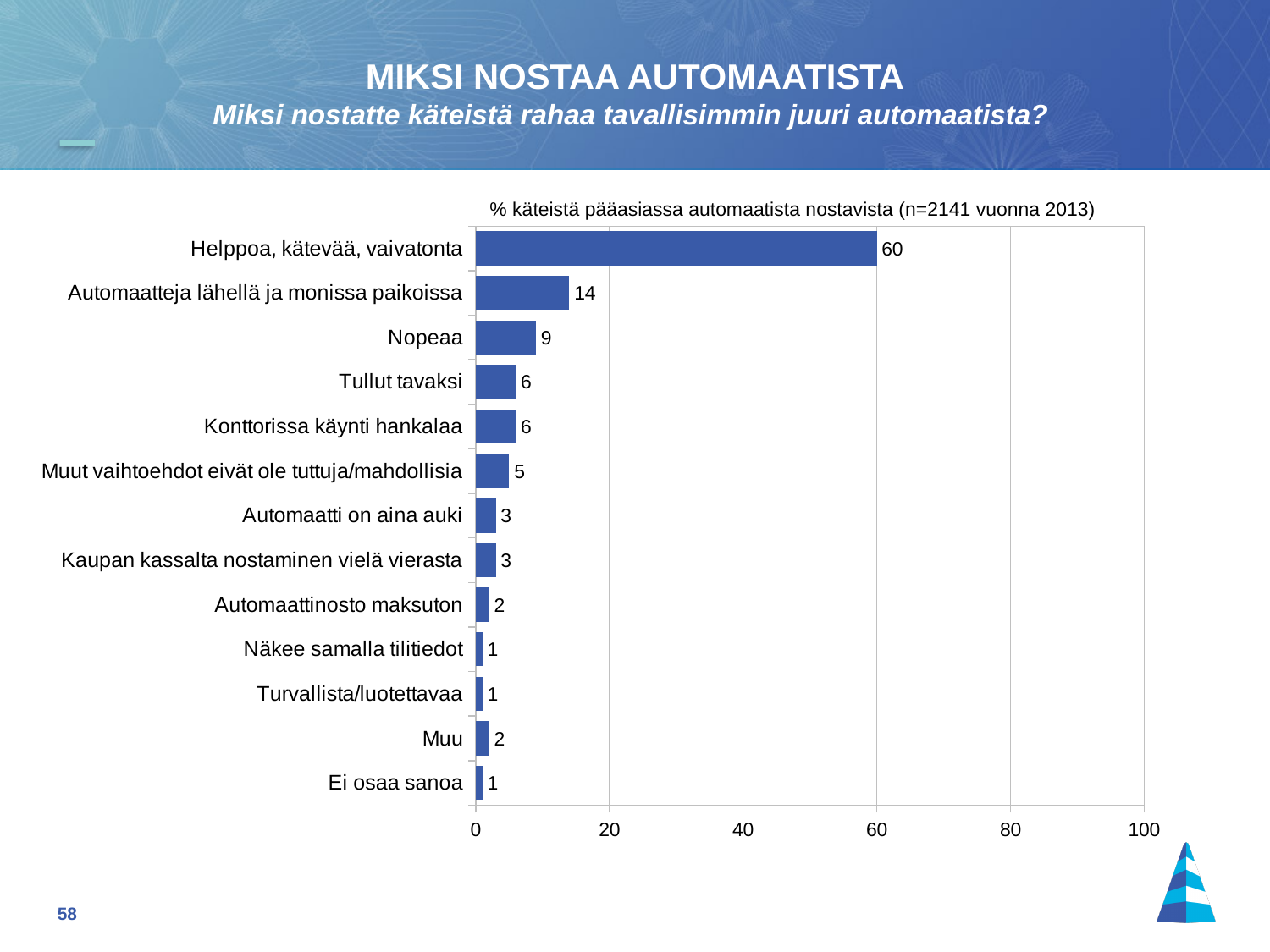
What is the value for "Automaatteja lähellä ja monissa paikoissa"? 14 What is the chart's title? % käteistä pääasiassa automaatista nostavista (n=2141 vuonna 2013) Which category has the highest value? Helppoa, kätevää, vaivatonta What is the value for "Nopeaa"? 9 What is the difference between the values for "Helppoa, kätevää, vaivatonta" and "Automaatteja lähellä ja monissa paikoissa"? 46 What is the value for "Muut vaihtoehdot eivät ole tuttuja/mahdollisia"? 5 Is the value for "Automaatteja lähellä ja monissa paikoissa" greater or less than 20? less What kind of chart is shown on the slide? bar chart What is the value for "Helppoa, kätevää, vaivatonta"? 60 What is the value for "Automaattinosto maksuton"? 2 Which is larger, the value for "Nopeaa" or the value for "Tullut tavaksi"? Nopeaa How many categories are shown in the chart? 13